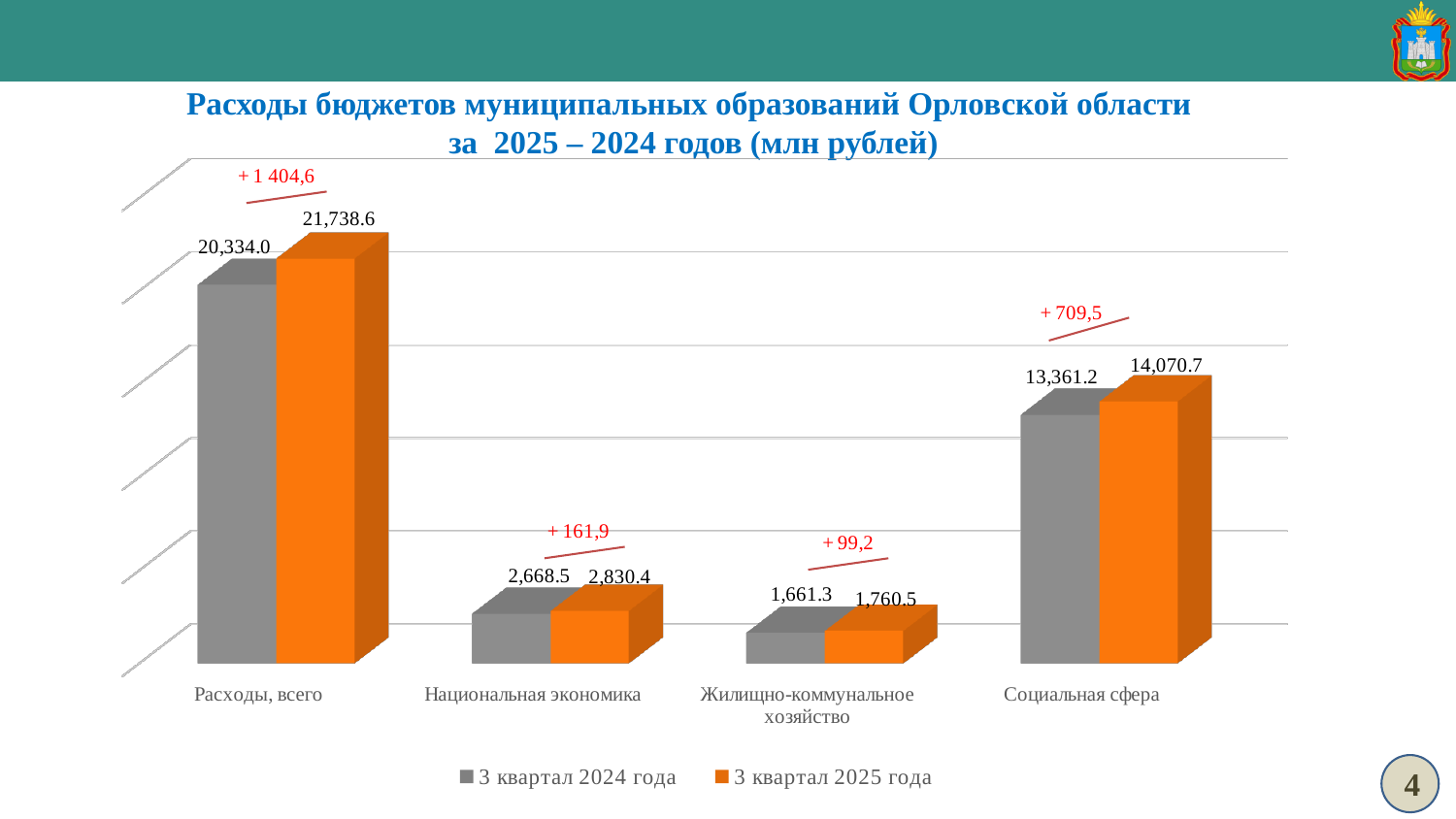
What is the value for Национальная экономика in the 3 квартал 2024 года series? 2,668.5 What is the value for Жилищно-коммунальное хозяйство in the 3 квартал 2025 года series? 1,760.5 How many categories are shown on the x axis of the chart? 4 What is the value for Социальная сфера in the 3 квартал 2024 года series? 13,361.2 Which category has the lowest value in the 3 квартал 2024 года series? Жилищно-коммунальное хозяйство What is the difference between the 3 квартал 2025 года and 3 квартал 2024 года values for Национальная экономика? 161.9 Which is larger: the 3 квартал 2024 года value for Социальная сфера or the 3 квартал 2025 года value for Национальная экономика? 3 квартал 2024 года value for Социальная сфера How many series does the legend list? 2 Which category has the highest value in the 3 квартал 2025 года series? Расходы, всего What is the difference between the 3 квартал 2025 года and 3 квартал 2024 года values for Социальная сфера? 709.5 What is the value for Расходы, всего in the 3 квартал 2025 года series? 21,738.6 What kind of chart is shown on the slide? Bar chart